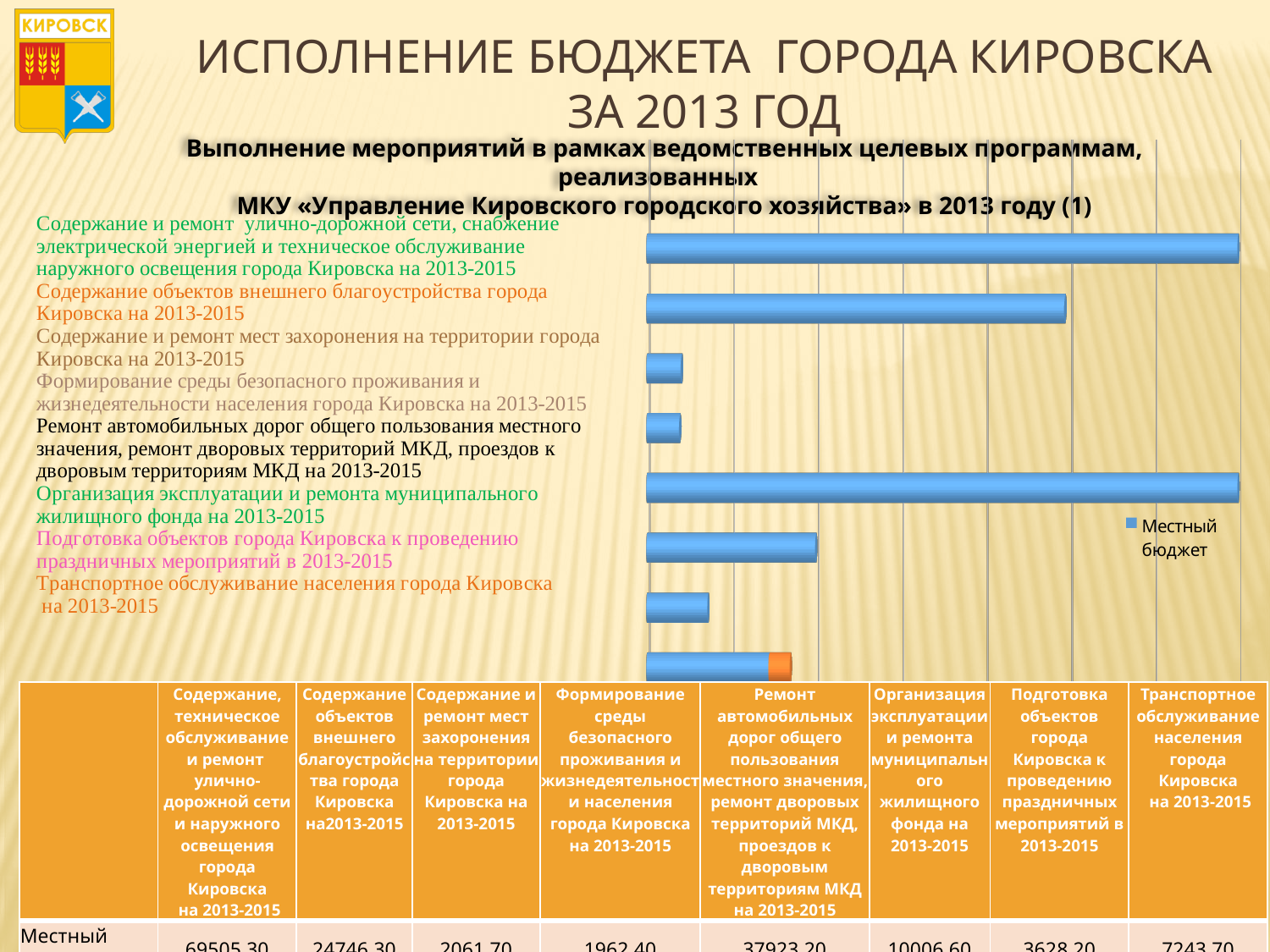
What is the name of the series shown in the chart legend? Местный бюджет How many categories (programmes) are plotted in the bar chart? 8 Which is larger: the bar for «Содержание объектов внешнего благоустройства города Кировска на 2013-2015» or the bar for «Организация эксплуатации и ремонта муниципального жилищного фонда на 2013-2015»? Содержание объектов внешнего благоустройства города Кировска на 2013-2015 Which is larger: the bar for «Транспортное обслуживание населения города Кировска на 2013-2015» or the bar for «Подготовка объектов города Кировска к проведению праздничных мероприятий в 2013-2015»? Транспортное обслуживание населения города Кировска на 2013-2015 What kind of chart is shown on the slide? bar chart Which is larger: the bar for «Содержание объектов внешнего благоустройства города Кировска на 2013-2015» or the bar for «Содержание и ремонт мест захоронения на территории города Кировска на 2013-2015»? Содержание объектов внешнего благоустройства города Кировска на 2013-2015 Are the bars in the chart drawn horizontally or vertically? horizontally How many series does the chart legend list? 1